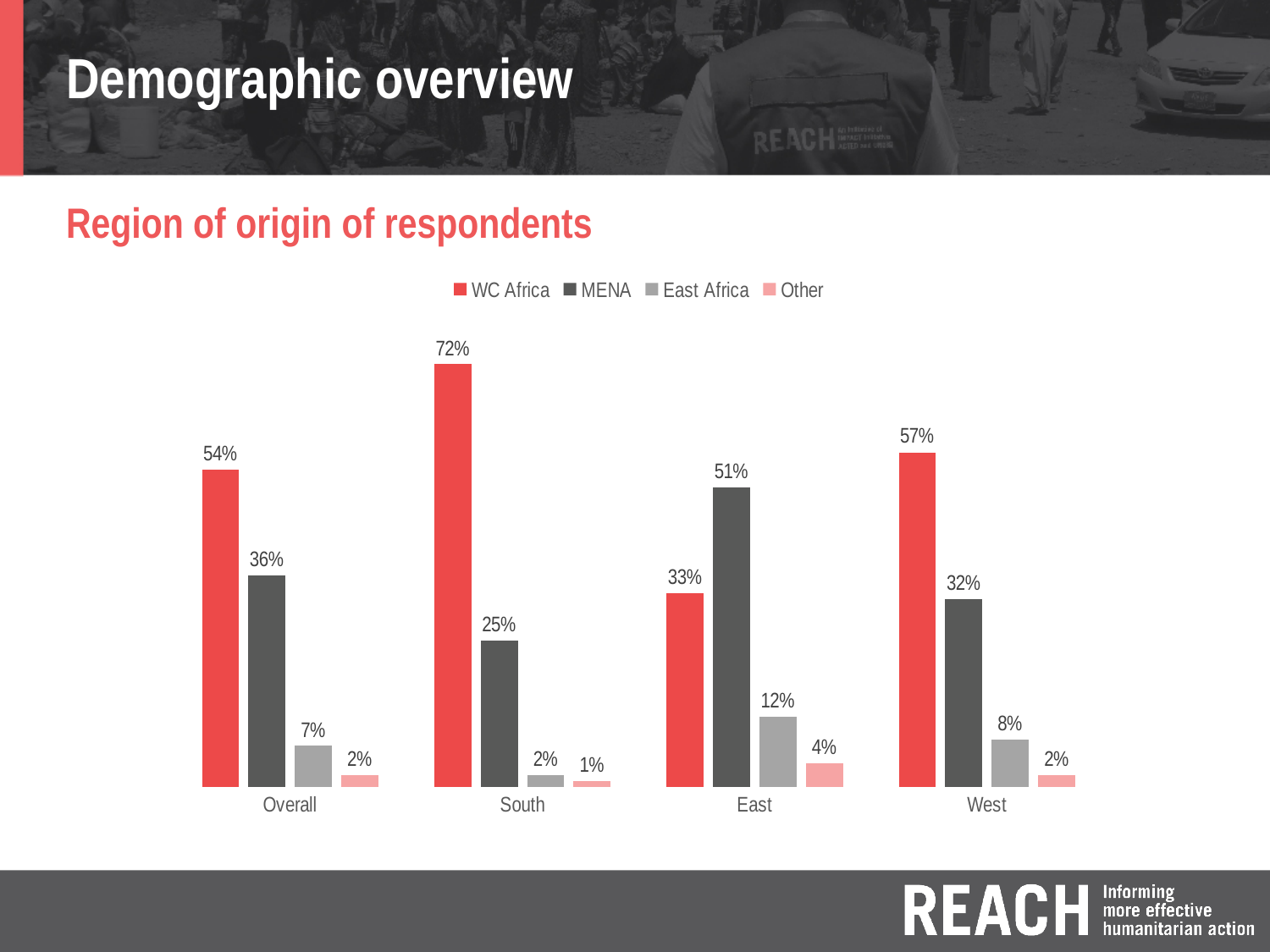
How many series does the legend list? 4 In which category is the Other value lowest? South What is the value for Other in the West category? 2% What is the difference between the WC Africa and MENA values in the Overall category? 18% What is the value for MENA in the East category? 51% What is the value for East Africa in the Overall category? 7% What is the title of the chart? Region of origin of respondents How many categories are shown on the x axis? 4 In which category is the WC Africa value highest? South Which is larger in the East category, WC Africa or MENA? MENA What is the value for WC Africa in the South category? 72% What kind of chart is shown on the slide? Bar chart